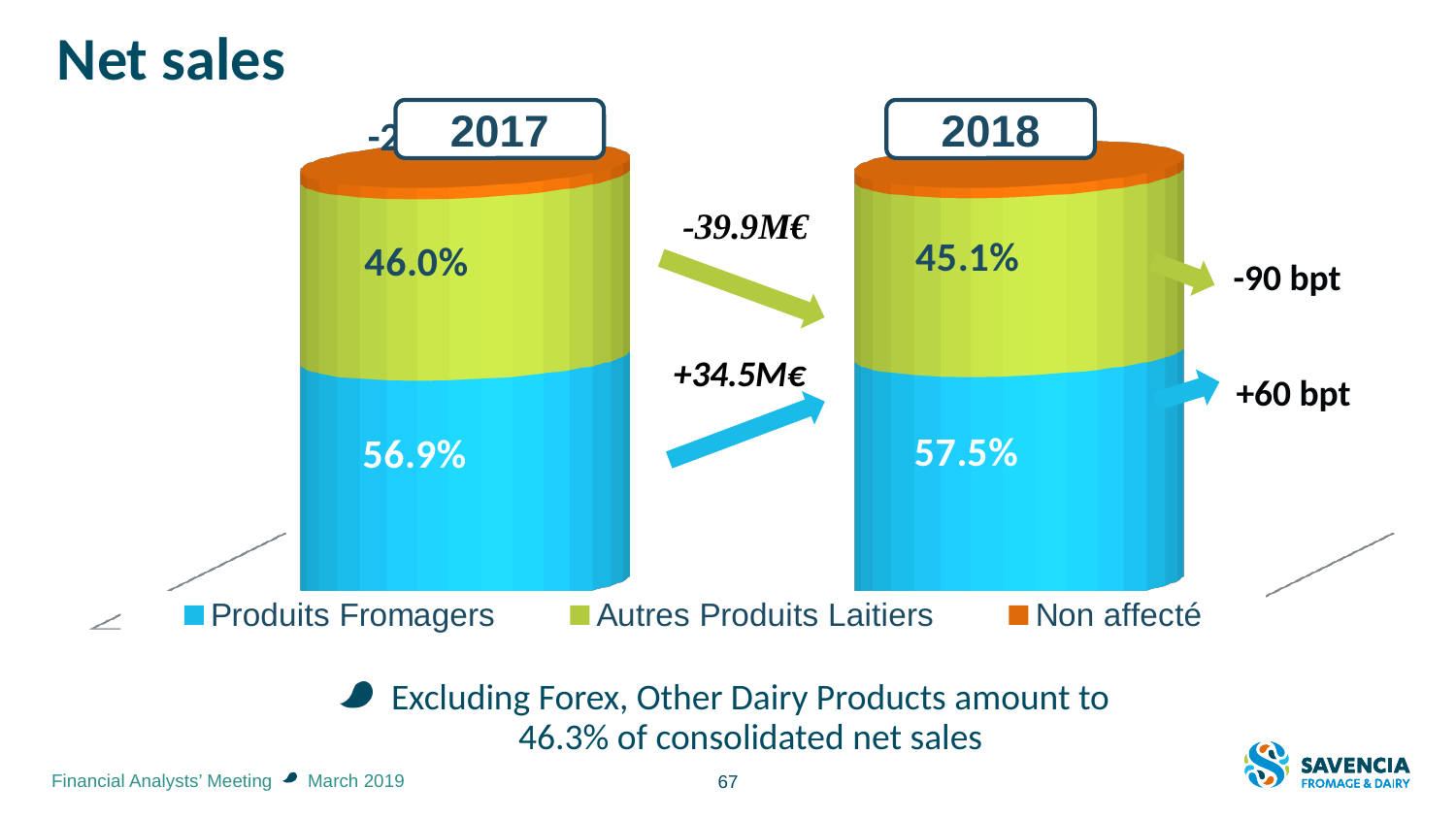
What is the value for Autres Produits Laitiers in 2018? 45.1% What is the value for Autres Produits Laitiers in 2017? 46.0% How many series does the legend list? 3 By how many percentage points did the Produits Fromagers share change from 2017 to 2018? 0.6 How many years are shown in the chart? 2 Which is larger in 2018: Produits Fromagers or Autres Produits Laitiers? Produits Fromagers What is the value for Produits Fromagers in 2018? 57.5% What kind of chart is shown on the slide? stacked bar chart Does the share of Produits Fromagers rise or fall from 2017 to 2018? rise Which series is shown in orange in the legend? Non affecté By how many percentage points did the Autres Produits Laitiers share change from 2017 to 2018? 0.9 What is the value for Produits Fromagers in 2017? 56.9%